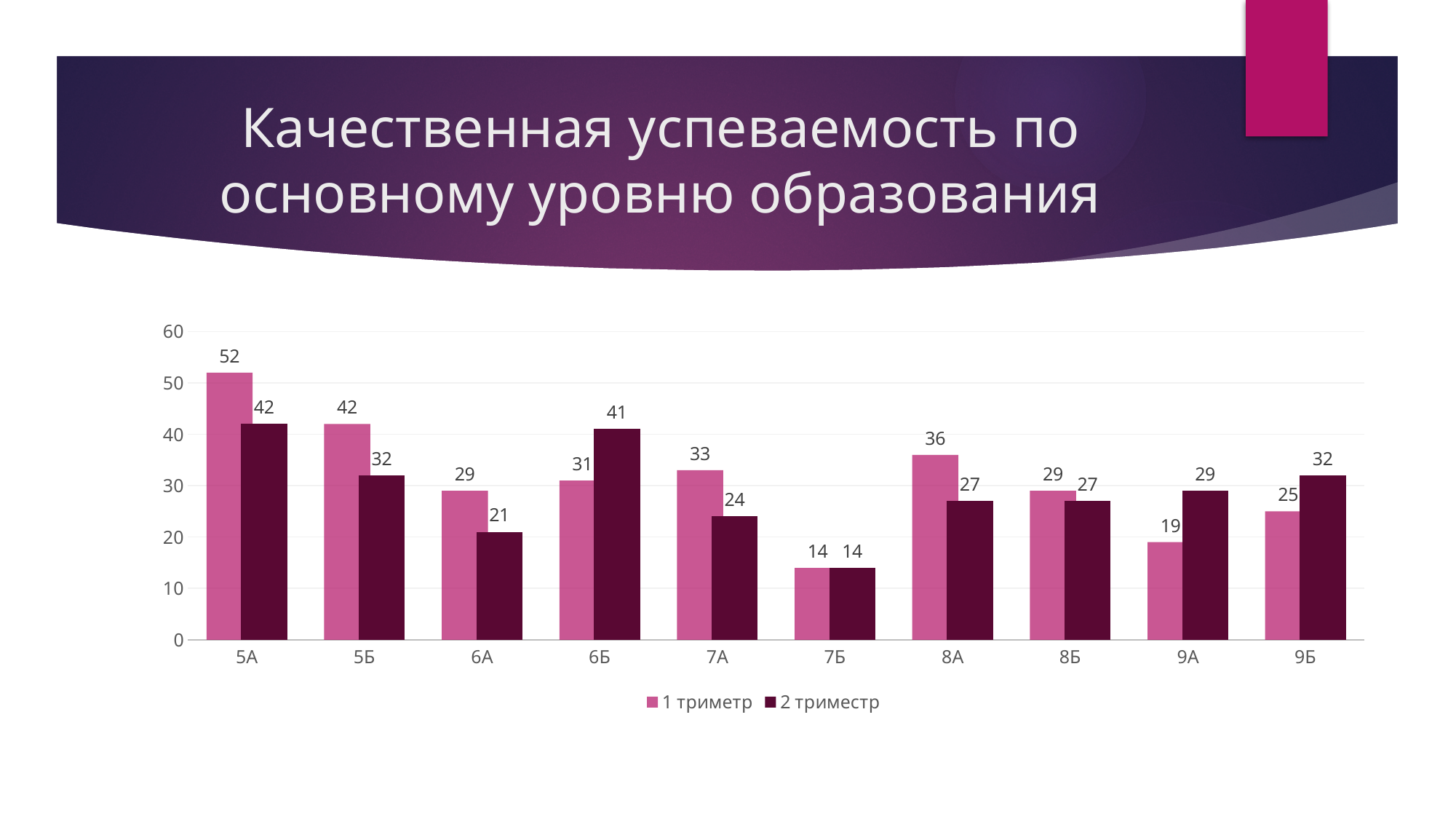
What is the title of the slide? Качественная успеваемость по основному уровню образования Which is larger for 6Б: the 1 триметр value or the 2 триместр value? 2 триместр Which category has the highest value in the 1 триметр series? 5А Which category has the lowest value in the 2 триместр series? 7Б How many series does the legend list? 2 What is the 2 триместр value for 7А? 24 How many categories are shown on the x axis? 10 What is the value for 9Б in the 2 триместр series? 32 What is the value for 5А in the 1 триметр series? 52 Is the 1 триметр value for 8А greater or less than 30? greater What kind of chart is shown on the slide? bar chart What is the difference between the 1 триметр and 2 триместр values for 5Б? 10